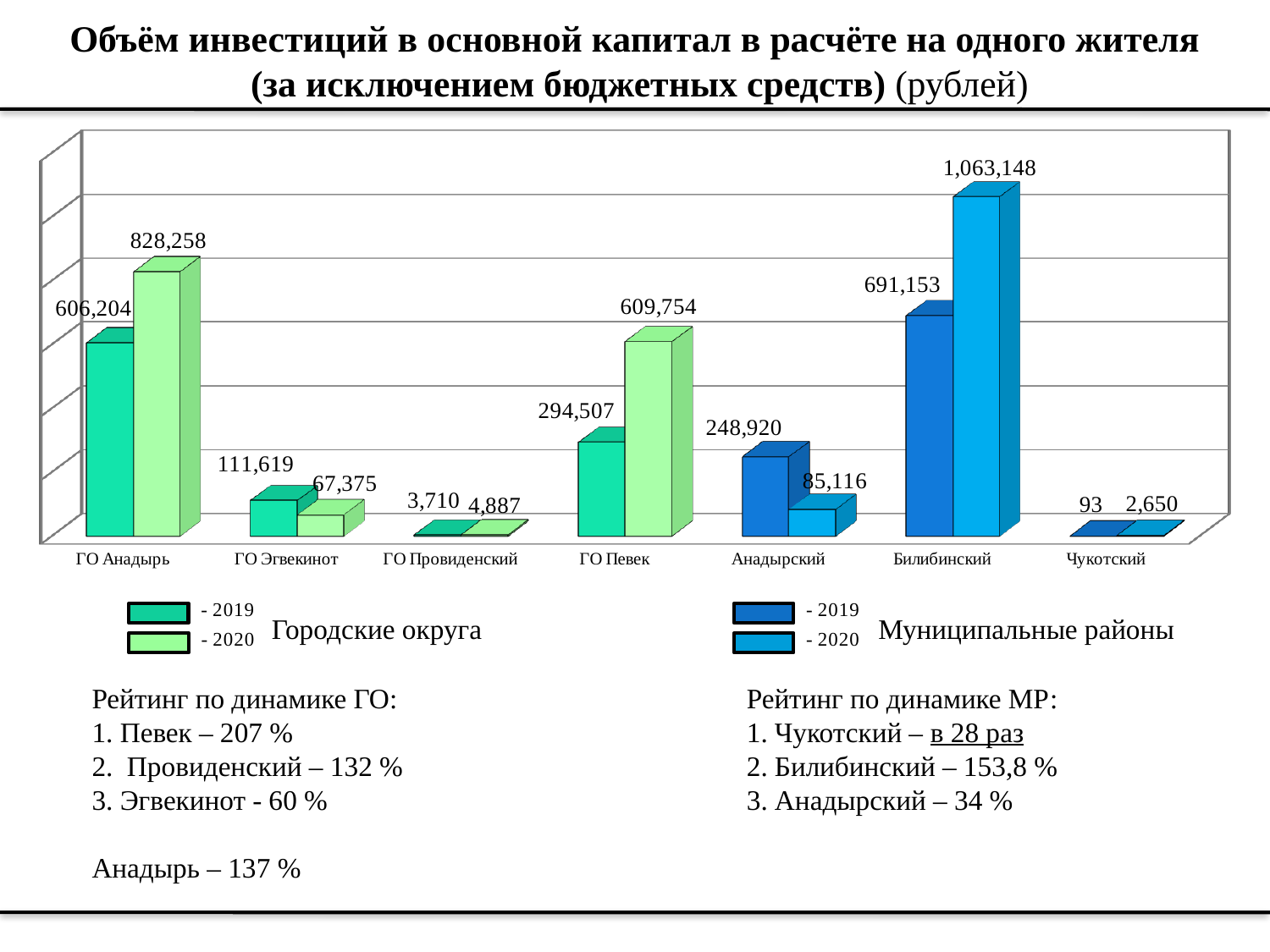
What is the 2020 value for ГО Эгвекинот? 67,375 What is the difference between the 2020 and 2019 values for ГО Провиденский? 1,177 What is the difference between the 2020 and 2019 values for ГО Анадырь? 222,054 Which is larger for Анадырский: the 2019 value or the 2020 value? 2019 How many categories are shown on the x axis? 7 Which category has the lowest 2019 value? Чукотский What is the 2019 value for Чукотский? 93 Which colour group in the legend represents Муниципальные районы? Blue What is the 2020 value for Билибинский? 1,063,148 Which category has the highest 2020 value? Билибинский What kind of chart is shown on the slide? Bar chart What is the 2019 value for ГО Певек? 294,507